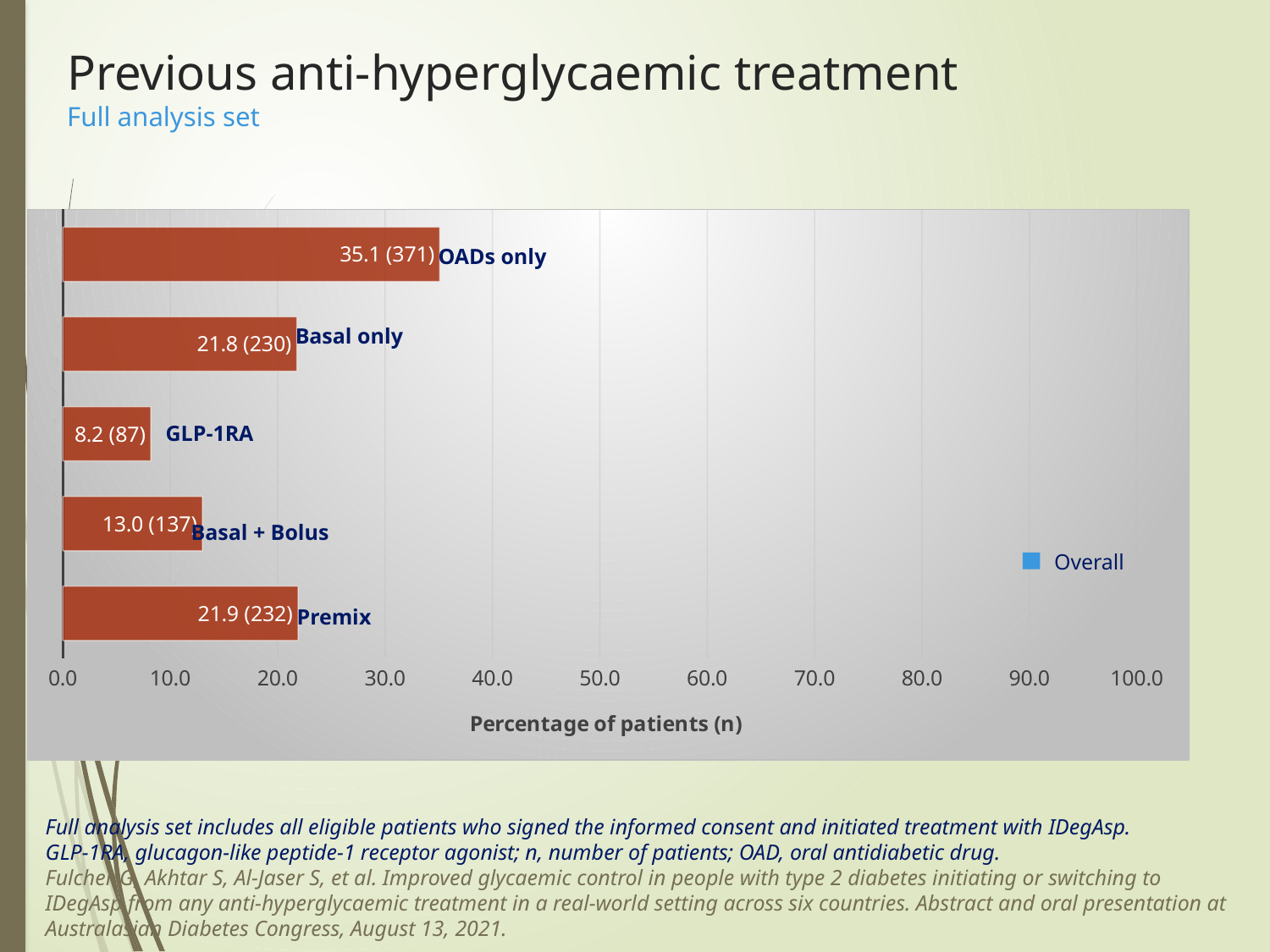
How many treatment categories are shown in the chart? 5 Which previous treatment category has the lowest percentage of patients? GLP-1RA What is the value shown for GLP-1RA? 8.2 (87) What is the value shown for OADs only? 35.1 (371) What is the value shown for Basal + Bolus? 13.0 (137) What is the value shown for Premix? 21.9 (232) What is the difference in percentage between OADs only and Basal only? 13.3 What kind of chart is shown on the slide? Bar chart Which is larger, the percentage for Basal + Bolus or for Premix? Premix What is the difference in percentage between Basal + Bolus and GLP-1RA? 4.8 Is the value for OADs only greater or less than 30.0? greater Which previous treatment category has the highest percentage of patients? OADs only